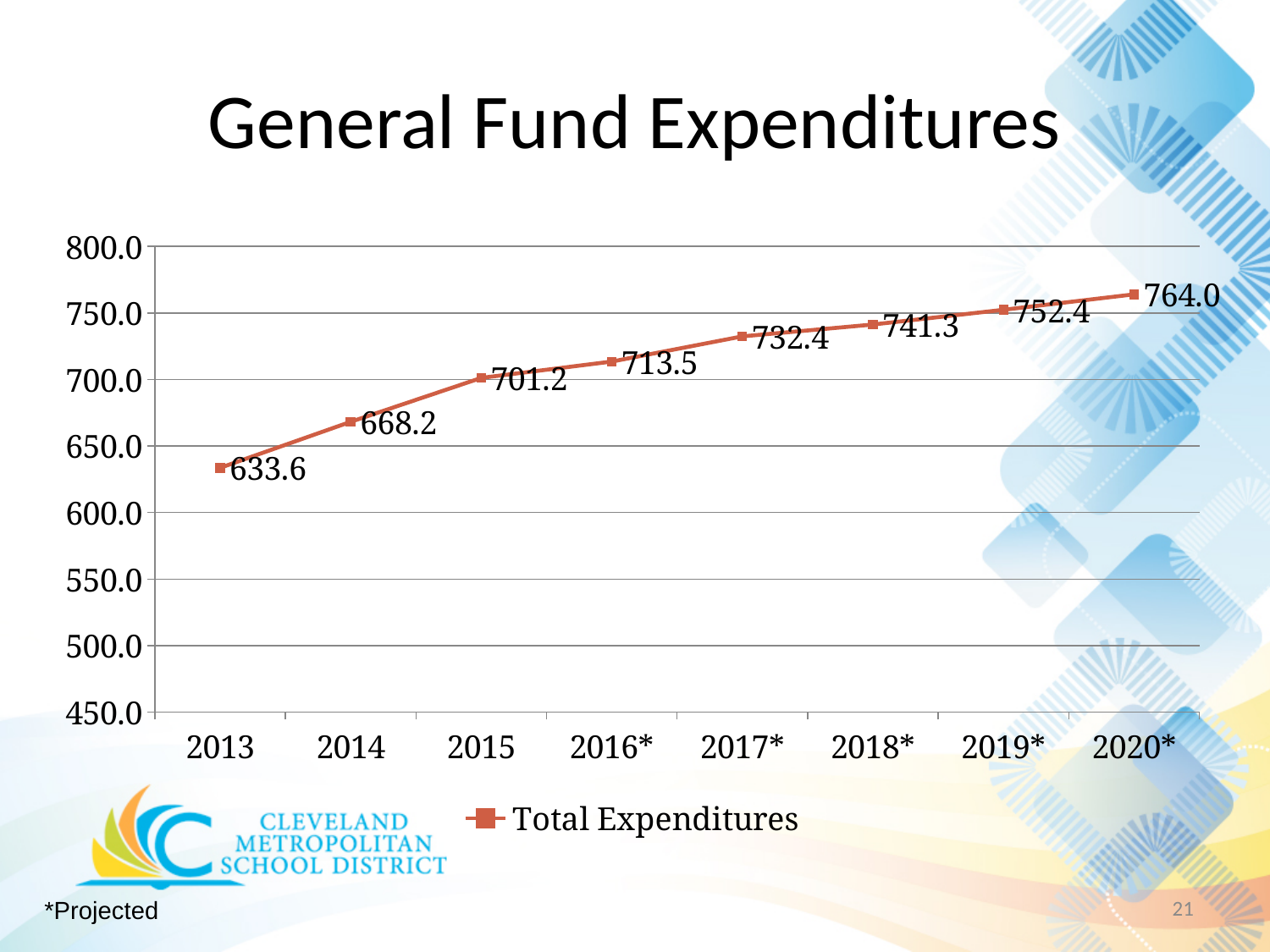
Which year has the highest Total Expenditures? 2020* What is the value of Total Expenditures for 2013? 633.6 How many years are plotted on the chart? 8 Which year has the lowest Total Expenditures? 2013 What kind of chart is shown on the slide? line chart What is the value of Total Expenditures for 2020*? 764.0 What is the value of Total Expenditures for 2017*? 732.4 What is the difference in Total Expenditures between 2020* and 2013? 130.4 Is the value for 2014 greater or less than 650.0? greater Which is larger, Total Expenditures in 2018* or in 2016*? 2018* Do Total Expenditures rise or fall from 2013 to 2020*? rise What is the difference in Total Expenditures between 2015 and 2014? 33.0